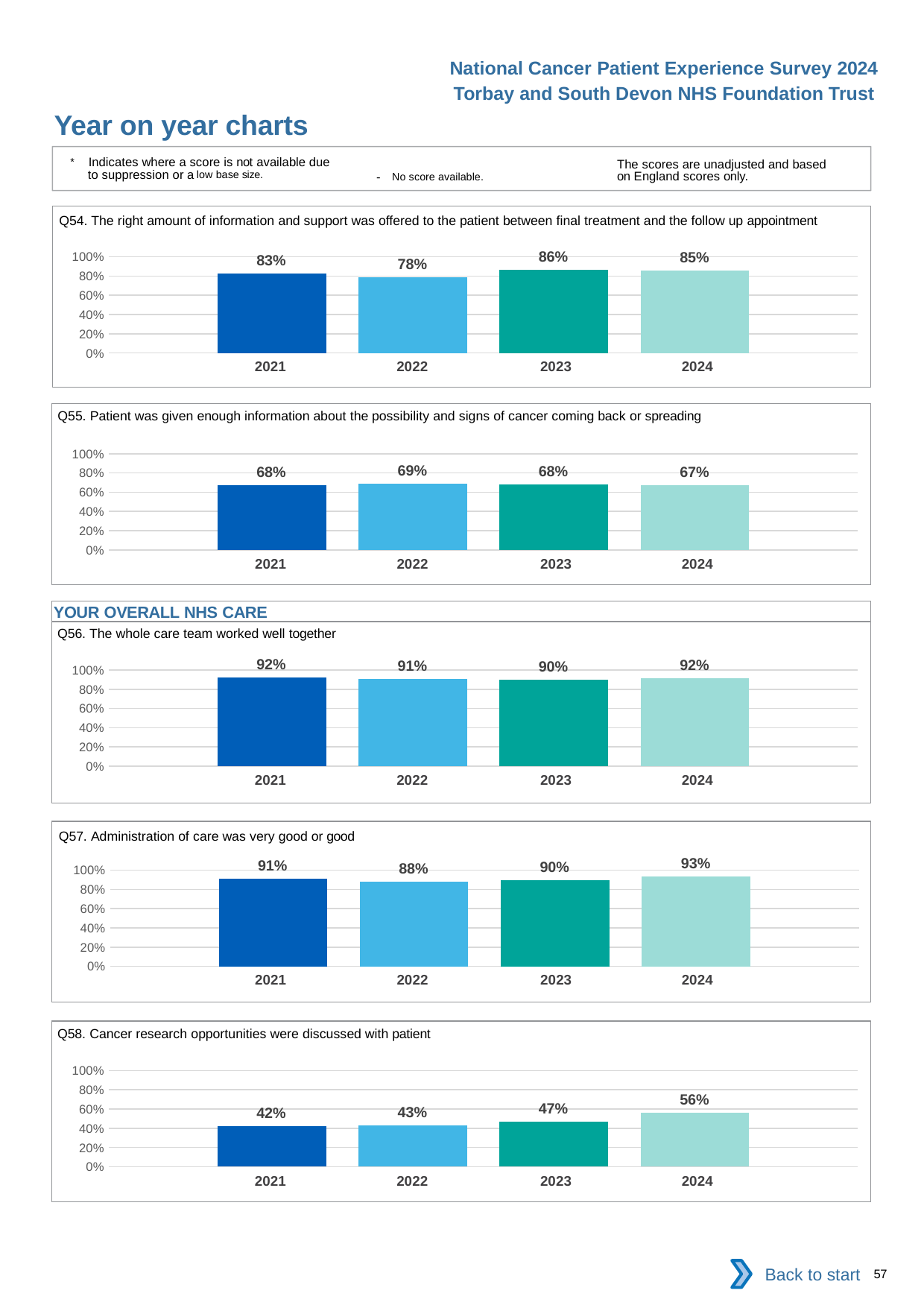
In the Q56 chart, which year has the lowest value? 2023 In the Q55 chart, what is the value for 2024? 67% How many years are shown on the x axis of the Q54 chart? 4 In the Q57 chart, what is the difference between the 2024 value and the 2022 value? 5 percentage points In the Q54 chart, which year has the lowest value? 2022 In the Q58 chart, what is the value for 2024? 56% In the Q56 chart, what is the value for 2021? 92% In the Q58 chart, is the value for 2021 greater or less than 60%? less In the Q54 chart, what is the value for 2023? 86% In the Q57 chart, which year has the highest value? 2024 In the Q58 chart, do the values rise or fall from 2021 to 2024? rise In the Q55 chart, what is the difference between the 2022 value and the 2024 value? 2 percentage points